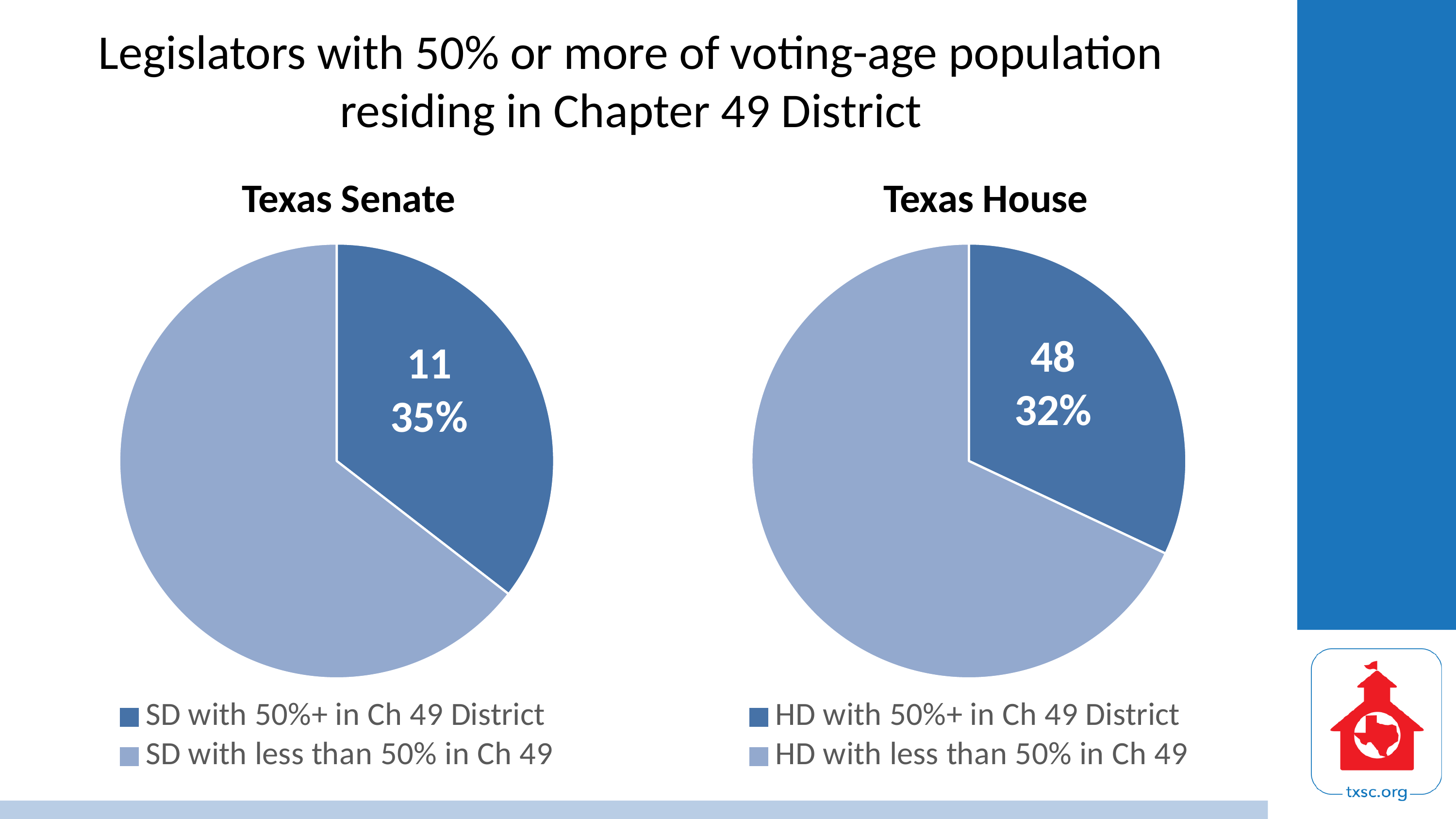
How many slices does the Texas Senate pie chart have? 2 How many entries does the legend of the Texas House chart list? 2 In the Texas Senate chart, what share of the pie is 'SD with 50%+ in Ch 49 District'? 35% In the Texas House chart, how many representatives are in the 'HD with 50%+ in Ch 49 District' slice? 48 Which is larger: the 50%+ share in the Texas Senate chart or the 50%+ share in the Texas House chart? Texas Senate What kind of chart is the Texas House chart? Pie chart In the Texas House chart, which slice is larger: 'HD with 50%+ in Ch 49 District' or 'HD with less than 50% in Ch 49'? HD with less than 50% in Ch 49 What is the title of the slide containing the two pie charts? Legislators with 50% or more of voting-age population residing in Chapter 49 District In the Texas House chart, what share of the pie is 'HD with 50%+ in Ch 49 District'? 32% What kind of chart is the Texas Senate chart? Pie chart In the Texas Senate chart, which slice is the smallest? SD with 50%+ in Ch 49 District In the Texas Senate chart, how many senators are in the 'SD with 50%+ in Ch 49 District' slice? 11